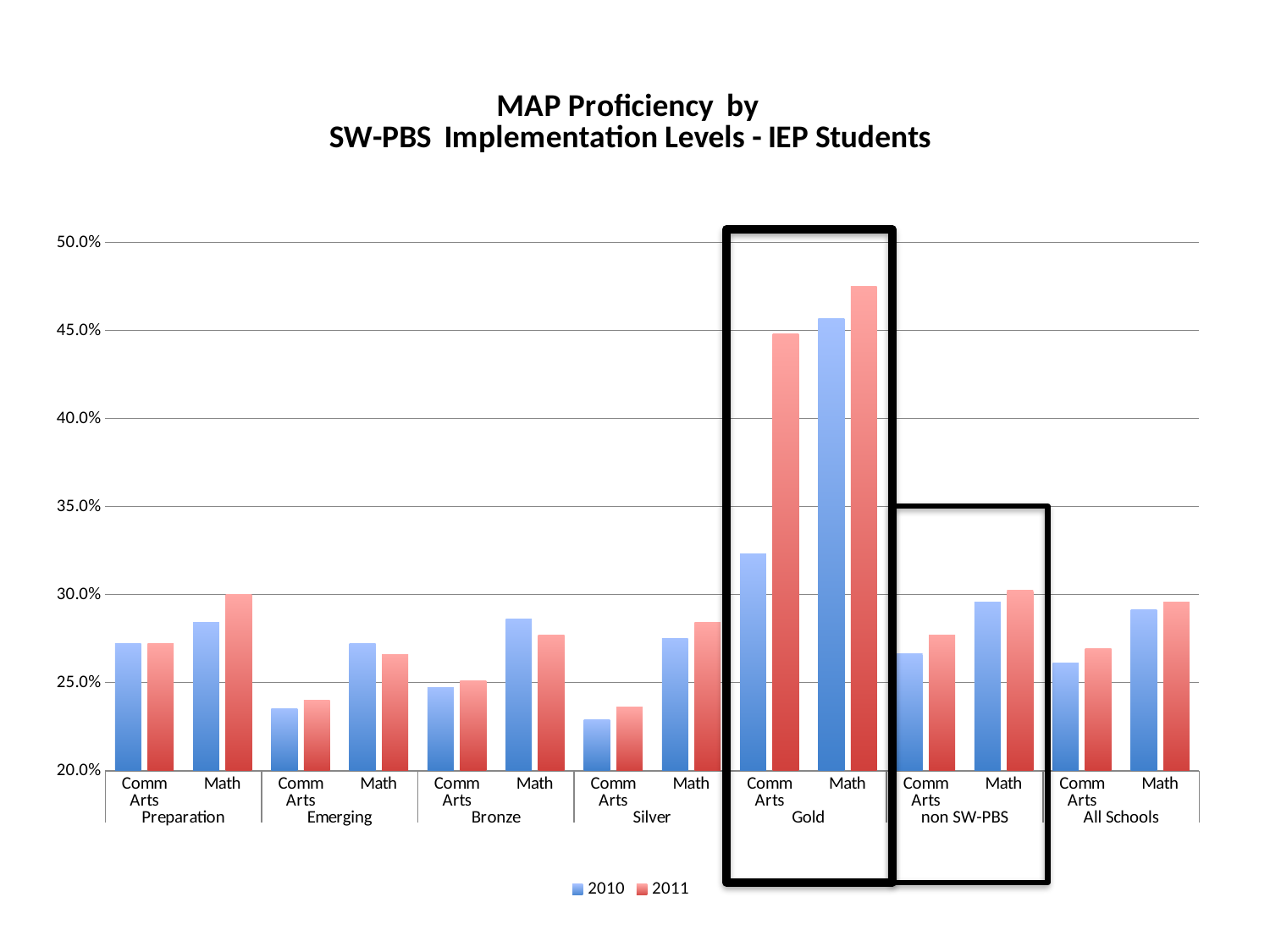
How many series does the legend list? 2 What is the title of the chart? MAP Proficiency by SW-PBS Implementation Levels - IEP Students Which is larger, the 2010 Math value for Gold or the 2010 Math value for non SW-PBS? Gold Which bar is the highest in the chart? Gold Math 2011 What kind of chart is shown on the slide? bar chart Is the 2010 value for Gold Comm Arts greater or less than 35.0%? less Which two groups are outlined with black boxes on the chart? Gold and non SW-PBS For Bronze Math, which year has the larger value, 2010 or 2011? 2010 Which bar is the lowest in the chart? Silver Comm Arts 2010 Is the 2011 value for Gold Comm Arts greater or less than 40.0%? greater Is the 2010 value for Silver Comm Arts greater or less than 25.0%? less How many implementation level groups are shown along the x axis? 7